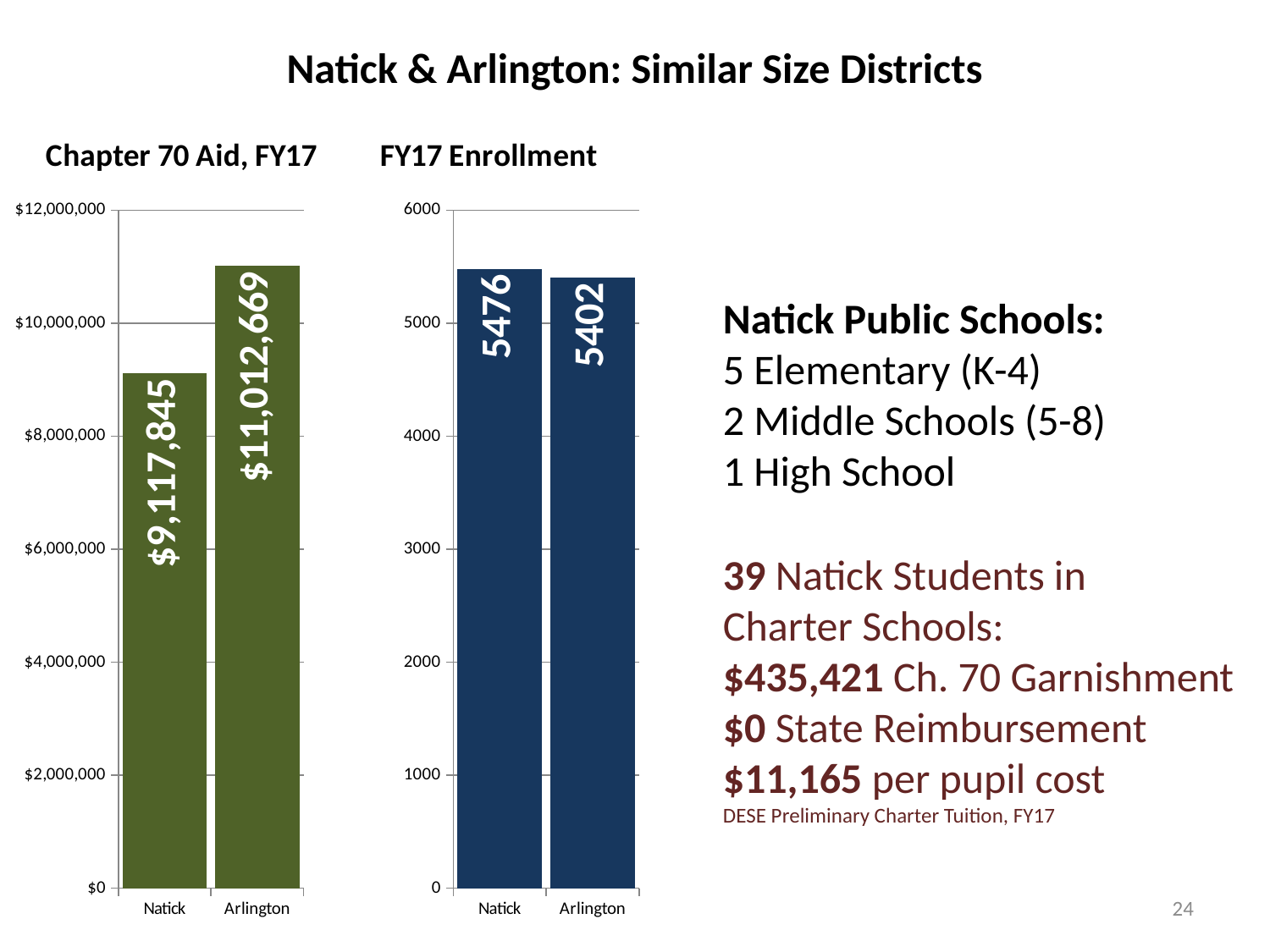
In the Chapter 70 Aid, FY17 chart, what is the value for Natick? $9,117,845 In the Chapter 70 Aid, FY17 chart, is the value for Natick greater or less than $10,000,000? less In the Chapter 70 Aid, FY17 chart, what is the value for Arlington? $11,012,669 In the Chapter 70 Aid, FY17 chart, how much more aid does Arlington receive than Natick? $1,894,824 In the FY17 Enrollment chart, what is the enrollment for Natick? 5476 In the FY17 Enrollment chart, what is the enrollment for Arlington? 5402 What type of chart is the FY17 Enrollment chart? Bar chart In the FY17 Enrollment chart, is Natick's enrollment greater or less than 5000? greater How many districts are shown in the Chapter 70 Aid, FY17 chart? 2 In the FY17 Enrollment chart, which district has the lower enrollment? Arlington In the Chapter 70 Aid, FY17 chart, which district receives the most aid? Arlington In the FY17 Enrollment chart, what is the difference in enrollment between Natick and Arlington? 74